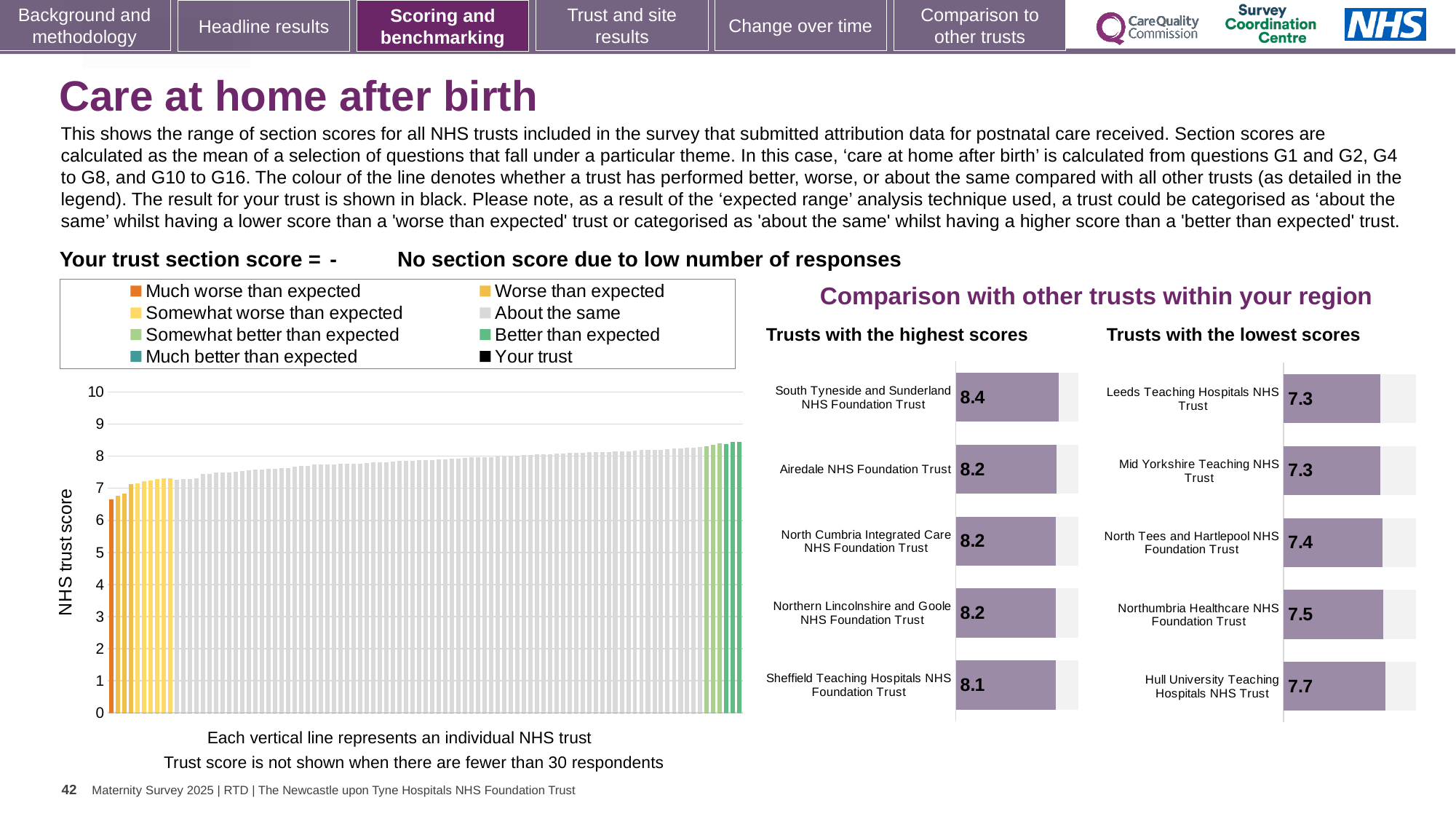
In the 'Trusts with the highest scores' chart, which trust has the lowest score? Sheffield Teaching Hospitals NHS Foundation Trust In the main 'NHS trust score' chart on the left, is the value of the shortest bar greater or less than 7? less How many trusts are shown in the 'Trusts with the lowest scores' chart? 5 In the 'Trusts with the highest scores' chart, what is the difference between the scores of South Tyneside and Sunderland NHS Foundation Trust and Sheffield Teaching Hospitals NHS Foundation Trust? 0.3 In the 'Trusts with the lowest scores' chart, what is the score for North Tees and Hartlepool NHS Foundation Trust? 7.4 How many entries does the legend above the main 'NHS trust score' chart list? 8 In the 'Trusts with the highest scores' chart, what is the score for South Tyneside and Sunderland NHS Foundation Trust? 8.4 In the 'Trusts with the lowest scores' chart, which has the larger score: Northumbria Healthcare NHS Foundation Trust or North Tees and Hartlepool NHS Foundation Trust? Northumbria Healthcare NHS Foundation Trust In the 'Trusts with the highest scores' chart, which trust has the highest score? South Tyneside and Sunderland NHS Foundation Trust In the 'Trusts with the lowest scores' chart, what is the score for Hull University Teaching Hospitals NHS Trust? 7.7 In the 'Trusts with the lowest scores' chart, which trust has the highest score? Hull University Teaching Hospitals NHS Trust In the main 'NHS trust score' chart on the left, is the value of the tallest bar greater or less than 8? greater